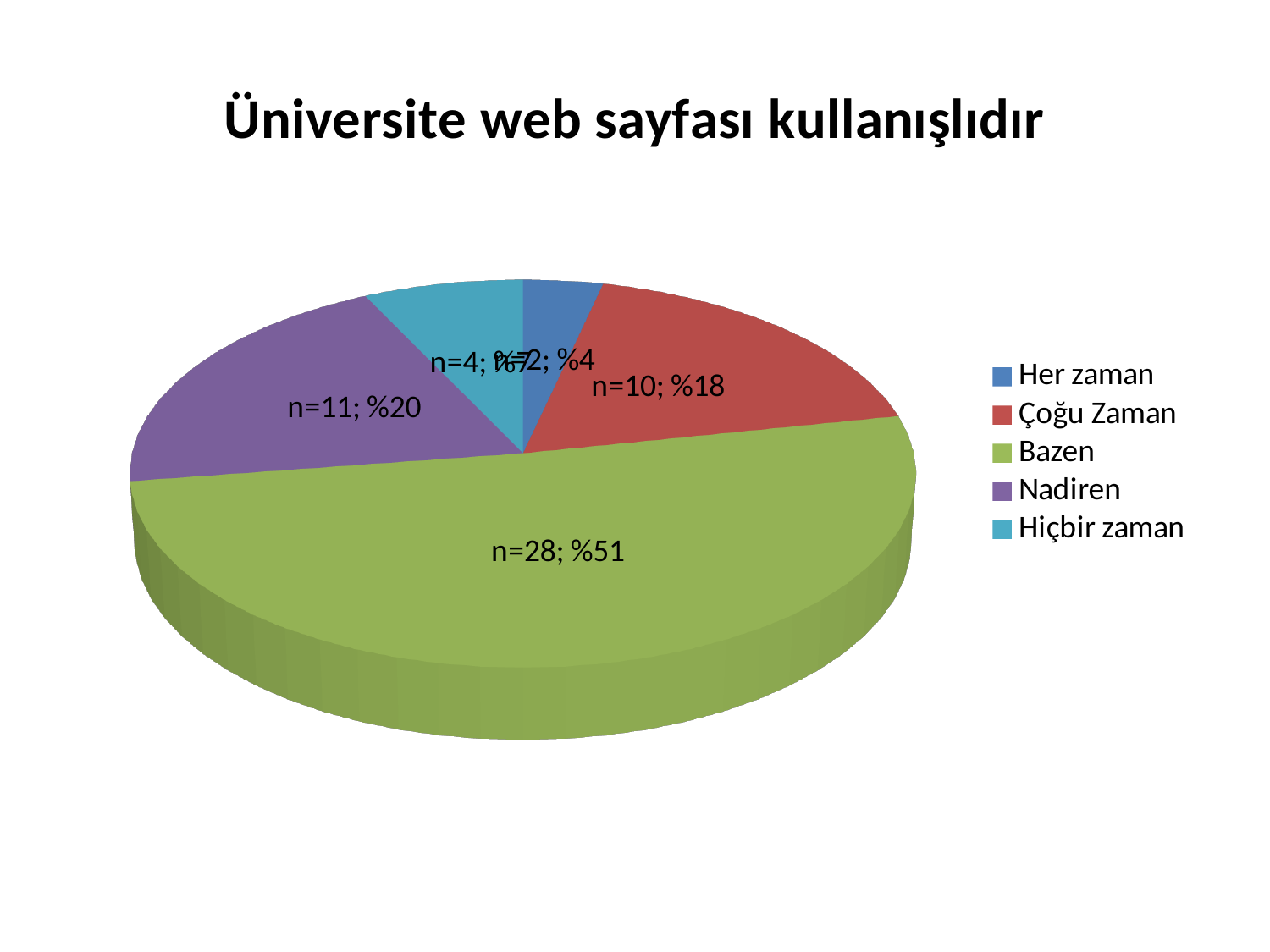
How many categories does the legend list? 5 Which has a larger share, Nadiren or Çoğu Zaman? Nadiren What is the n value for Çoğu Zaman? 10 What is the n value for Hiçbir zaman? 4 What colour is the Bazen slice? green Which category has the largest slice of the pie? Bazen What percentage is shown for Nadiren? %20 Which category has the smallest slice of the pie? Her zaman What kind of chart is shown on the slide? pie chart What is the difference in n between Bazen and Nadiren? 17 What is the title of the chart? Üniversite web sayfası kullanışlıdır What share of the pie does the Bazen slice represent? %51